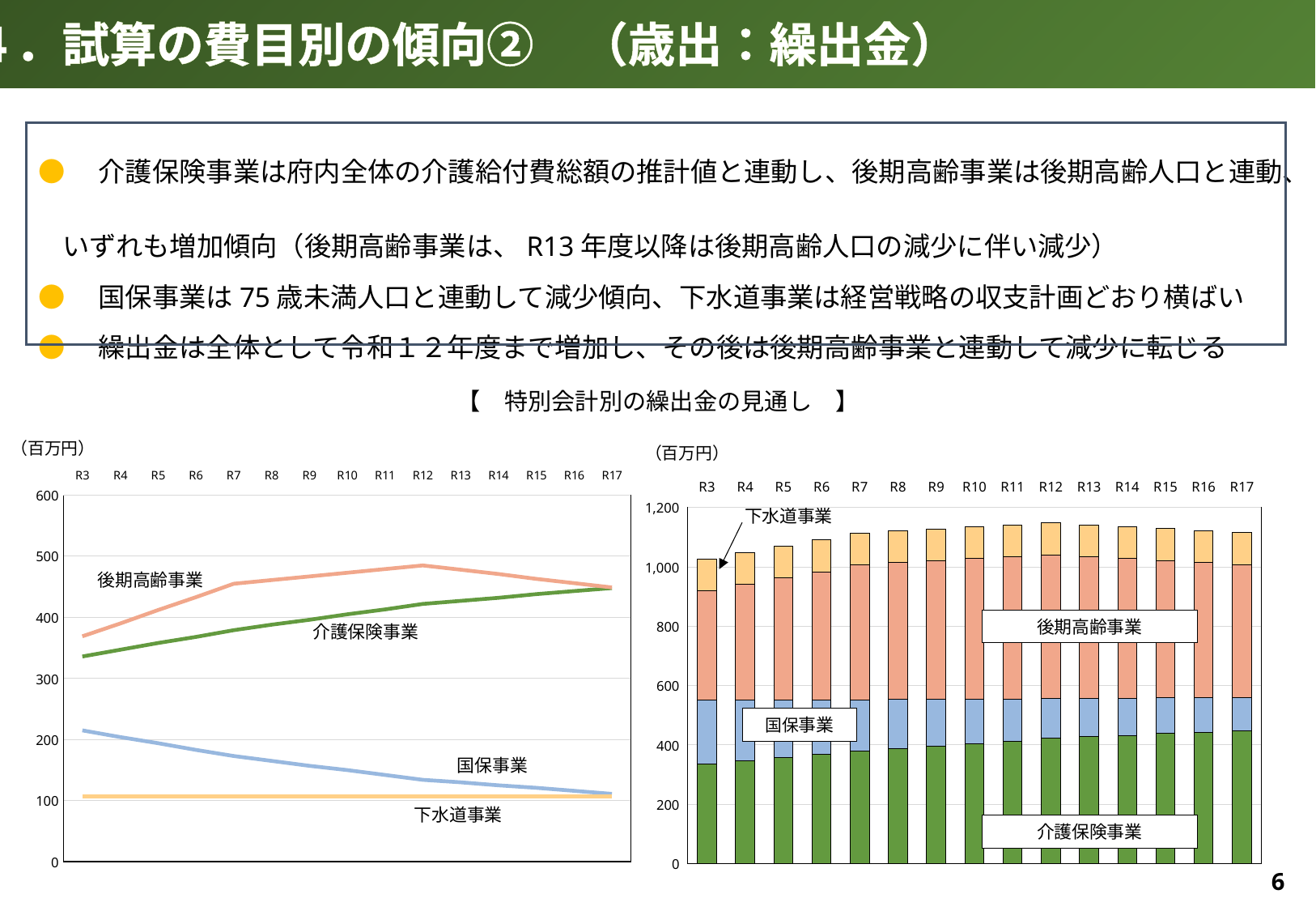
In the left chart, does the 介護保険事業 line rise or fall from R3 to R17? rise In the left chart, which series has the lowest value at R3? 下水道事業 In the left chart, is the value for 後期高齢事業 at R3 greater or less than 400? less In the left chart, which series has the highest value at R3? 後期高齢事業 In the left chart, is the value for 介護保険事業 at R17 greater or less than 400? greater In the right chart, how many series are stacked in each bar? 4 In the left chart, which line stays flat across all years? 下水道事業 In the left chart, does the 国保事業 line rise or fall from R3 to R17? fall What kind of chart is the right chart on the slide? bar chart In the left chart, how many fiscal years are shown on the x axis? 15 What kind of chart is the left chart on the slide? line chart In the right chart, is the 介護保険事業 segment at R3 greater or less than 400? less